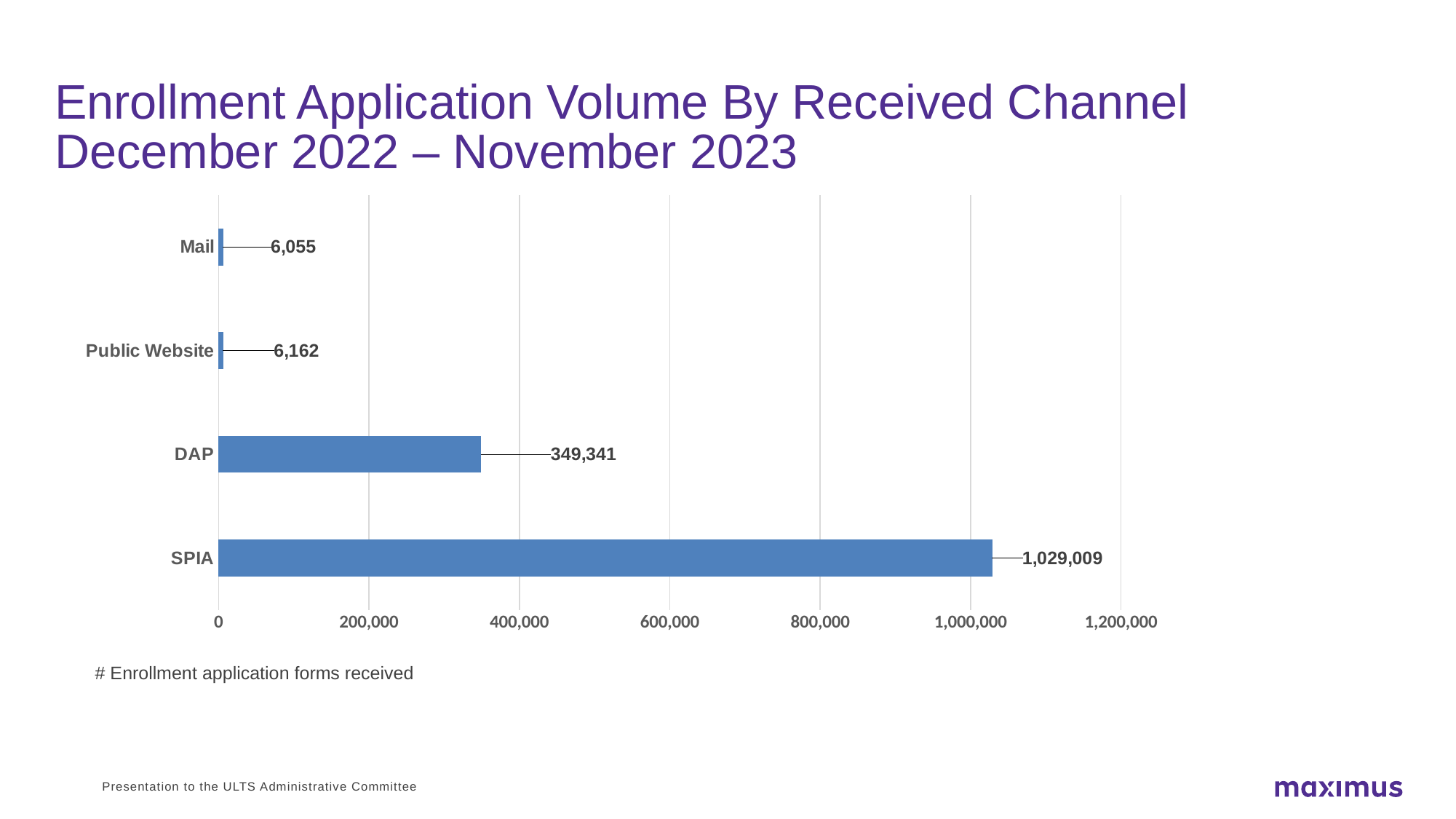
What is the enrollment application volume for DAP? 349,341 Which has a larger enrollment application volume, DAP or Public Website? DAP How many received channels are shown in the chart? 4 What is the enrollment application volume for Public Website? 6,162 What is the difference between the SPIA and DAP enrollment application volumes? 679,668 Is the value for SPIA greater or less than 1,000,000? greater What kind of chart is shown on the slide? Bar chart What is the enrollment application volume for SPIA? 1,029,009 Which received channel has the lowest enrollment application volume? Mail What is the difference between the Public Website and Mail enrollment application volumes? 107 Which received channel has the highest enrollment application volume? SPIA What is the enrollment application volume for Mail? 6,055